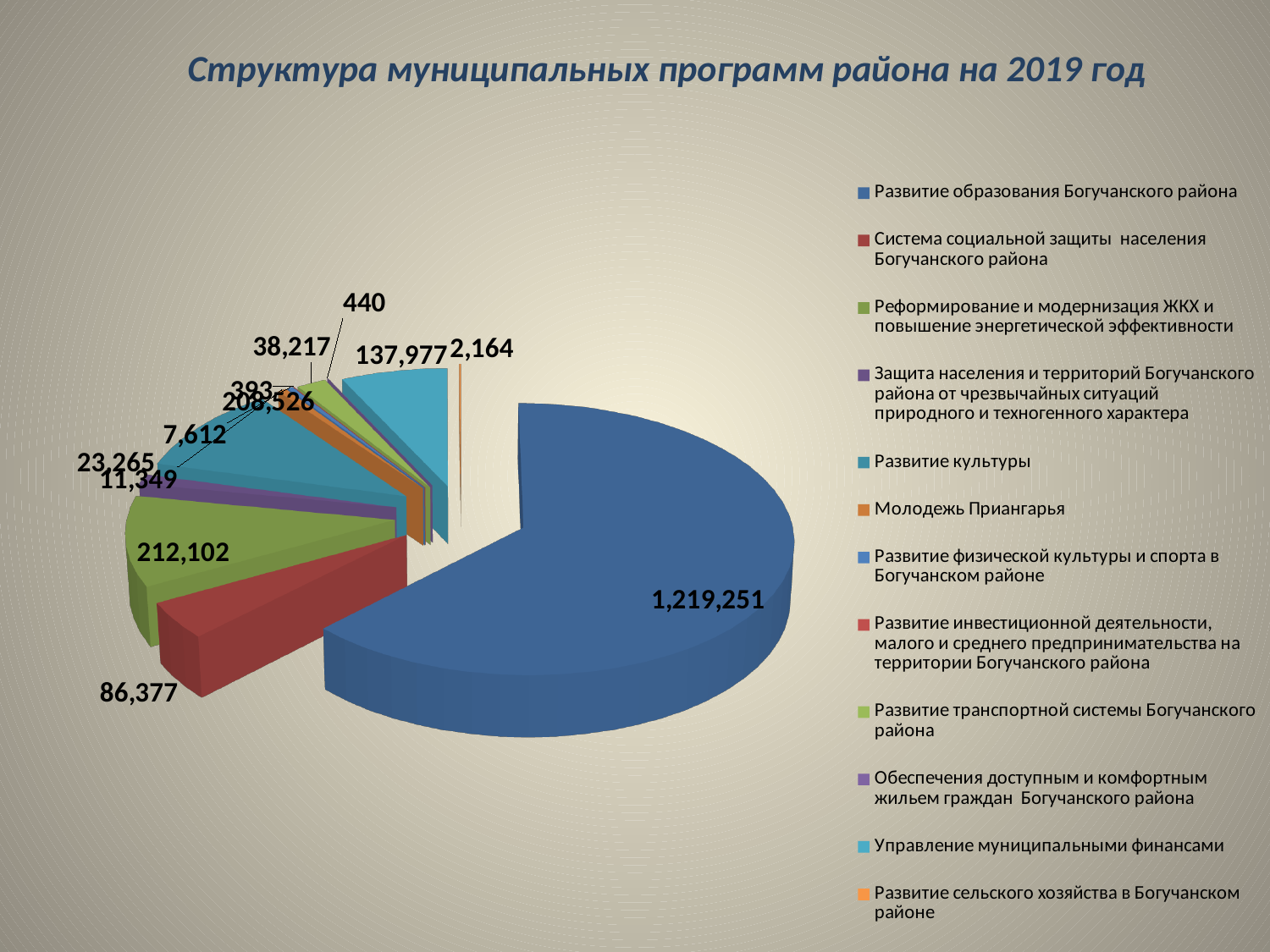
What is the value for Система социальной защиты населения Богучанского района? 86,377 What is the difference between the values for Развитие образования Богучанского района and Реформирование и модернизация ЖКХ и повышение энергетической эффективности? 1,007,149 How many categories does the legend of the pie chart list? 12 Which category has the largest slice of the pie? Развитие образования Богучанского района What is the value for Развитие сельского хозяйства в Богучанском районе? 2,164 What is the smallest value printed on the pie chart? 393 What is the title of the chart? Структура муниципальных программ района на 2019 год What is the value for Управление муниципальными финансами? 137,977 What is the value for Реформирование и модернизация ЖКХ и повышение энергетической эффективности? 212,102 What is the value for Развитие образования Богучанского района? 1,219,251 What type of chart is shown on the slide? pie chart Which is larger: the value for Реформирование и модернизация ЖКХ и повышение энергетической эффективности or the value for Система социальной защиты населения Богучанского района? Реформирование и модернизация ЖКХ и повышение энергетической эффективности